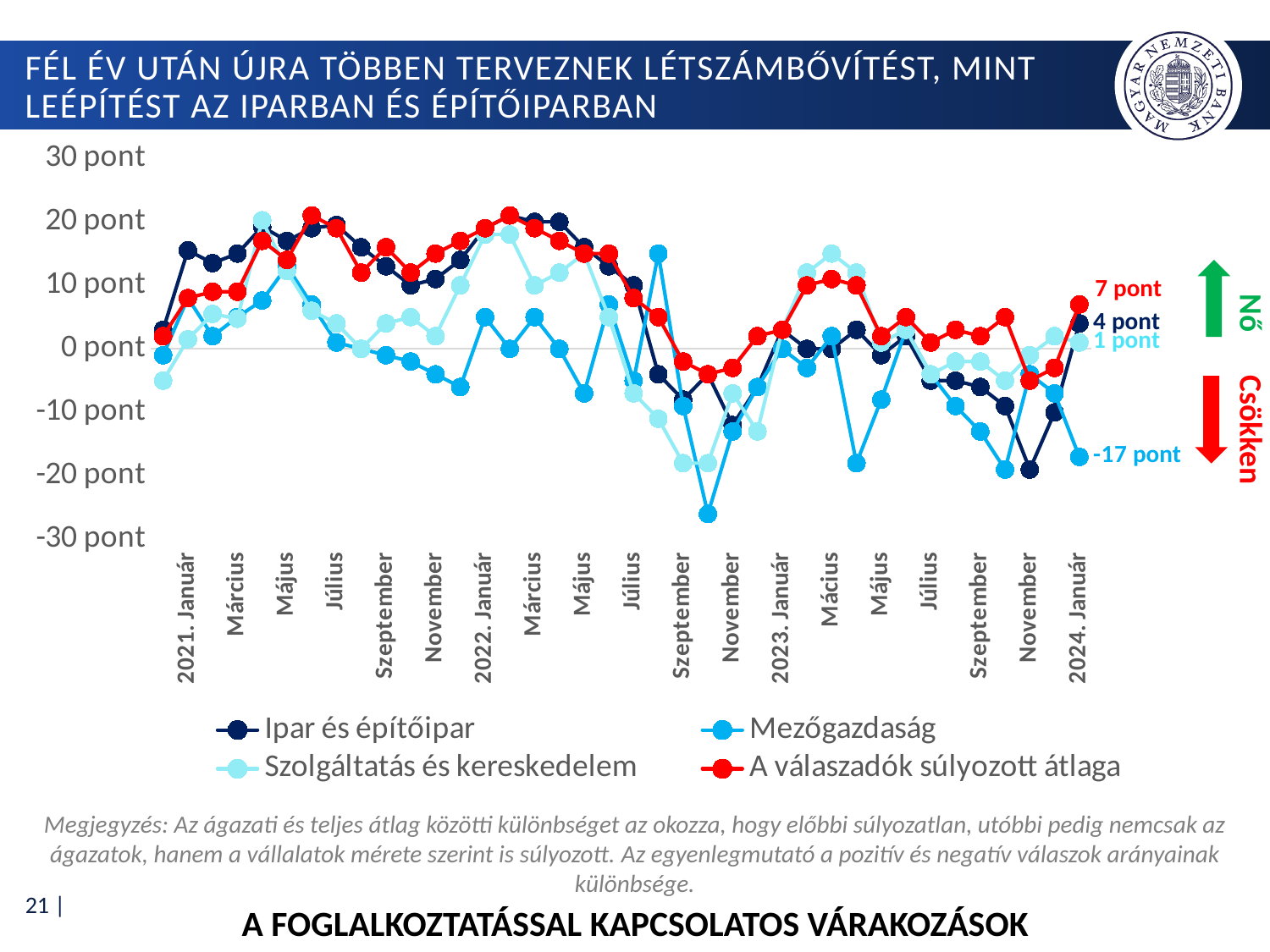
What is the difference between A válaszadók súlyozott átlaga and Mezőgazdaság in 2024. Január? 24 pont Does the Ipar és építőipar series rise or fall between 2022. Március and 2022. Szeptember? fall What is the value for Mezőgazdaság in 2024. Január? -17 pont What is the value for A válaszadók súlyozott átlaga in 2024. Január? 7 pont What is the value for Szolgáltatás és kereskedelem in 2024. Január? 1 pont What kind of chart is shown on the slide? line chart What is the value for Ipar és építőipar in 2024. Január? 4 pont How many series does the legend list? 4 Which series has the lowest value in 2024. Január? Mezőgazdaság Is the value for Ipar és építőipar in November 2023 greater or less than -10 pont? less Which series has the highest value in 2024. Január? A válaszadók súlyozott átlaga In 2024. Január, which is larger: Ipar és építőipar or Szolgáltatás és kereskedelem? Ipar és építőipar